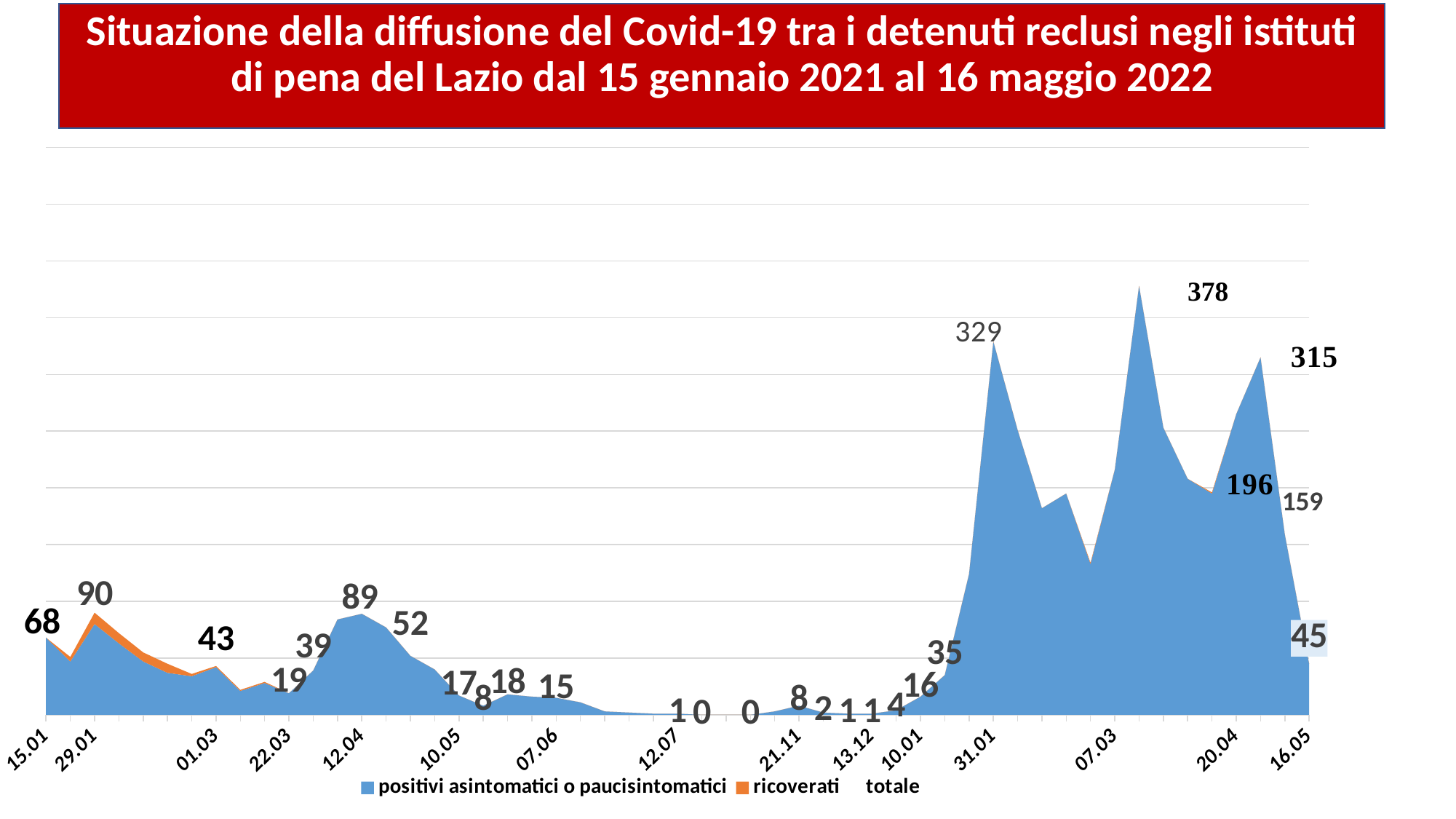
Do the values rise or fall between 12.07 and 31.01? rise What kind of chart is shown on the slide? area chart What is the value labelled at the peak at 31.01? 329 What is the lowest value labelled on the chart? 0 What is the value labelled at the first date, 15.01? 68 How many series does the legend list? 3 What is the highest value labelled on the chart? 378 What is the difference between the labelled values 378 and 315? 63 Which is larger, the peak labelled 329 or the peak labelled 315? 329 What is the difference between the highest labelled value, 378, and the peak labelled 329? 49 Which colour represents the 'ricoverati' series in the legend? orange What is the value labelled at the last date, 16.05? 45